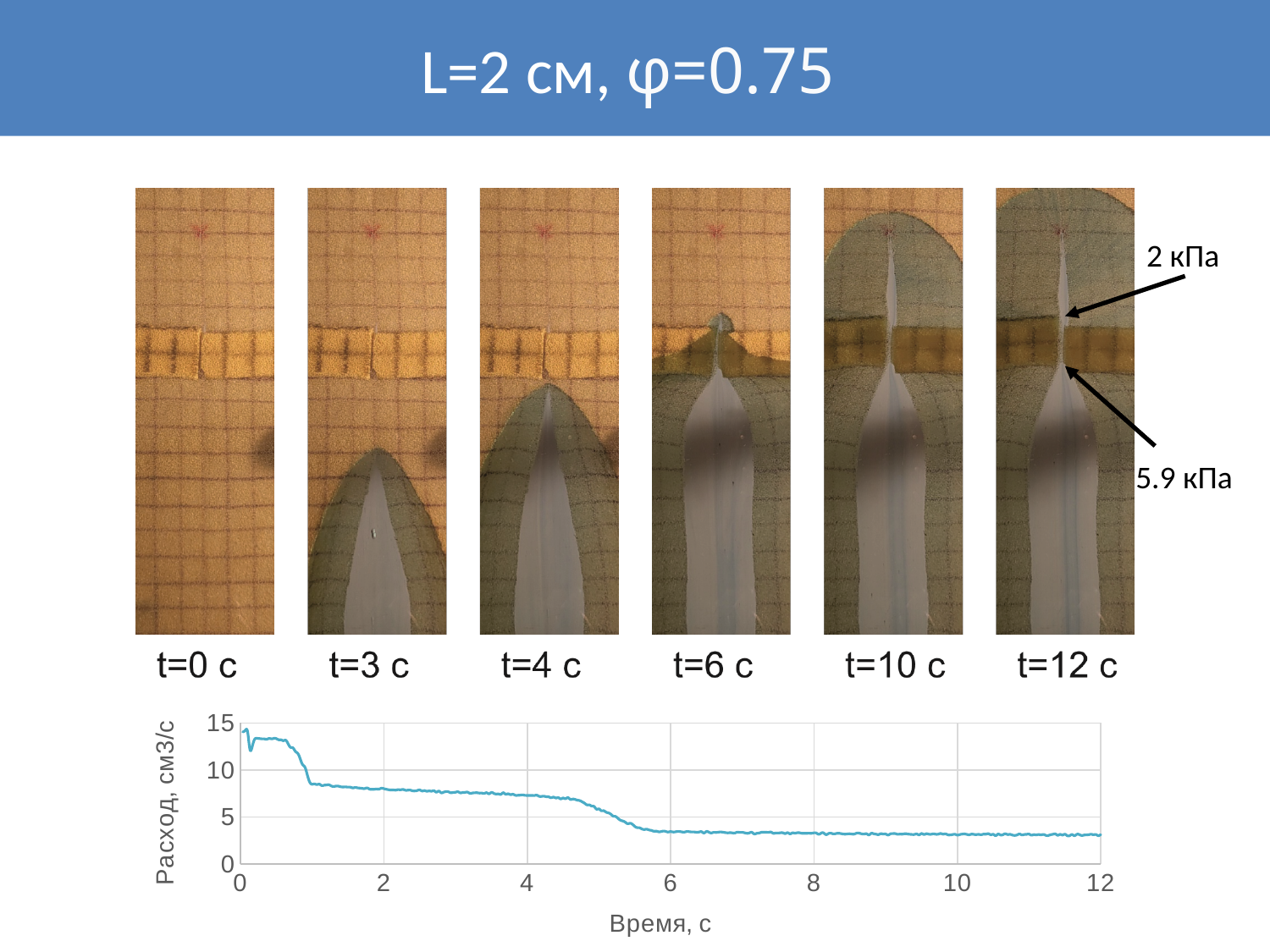
Is the value of the line at time 0.5 с greater or less than 10? greater Is the value of the line at time 1.5 с greater or less than 5? greater Is the value of the line at time 2 с greater or less than 5? greater How many lines are plotted in the chart? 1 What is the label of the x axis of the chart? Время, с Do the values in the chart generally rise or fall as time increases along the x axis? fall What is the highest tick value shown on the x axis of the chart? 12 What is the label of the y axis of the chart? Расход, см3/с What kind of chart is shown at the bottom of the slide? line chart